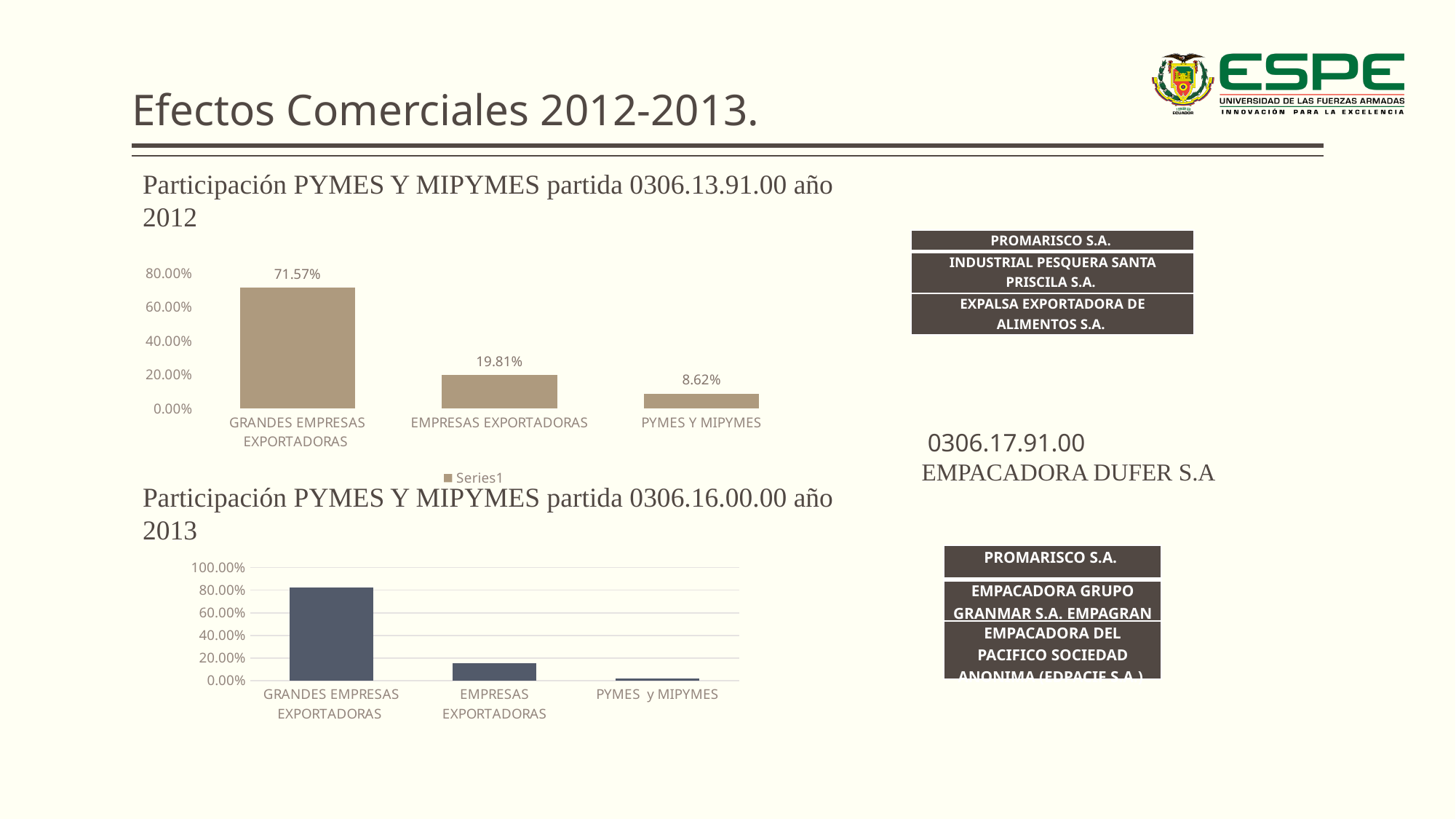
In the 2012 chart (partida 0306.13.91.00), what series name does the legend show? Series1 In the 2012 chart (partida 0306.13.91.00), which category has the lowest value? PYMES Y MIPYMES In the 2013 chart (partida 0306.16.00.00), is the value for GRANDES EMPRESAS EXPORTADORAS greater or less than 60.00%? greater In the 2012 chart (partida 0306.13.91.00), what is the value for PYMES Y MIPYMES? 8.62% In the 2013 chart (partida 0306.16.00.00), which category has the lowest value? PYMES y MIPYMES In the 2012 chart (partida 0306.13.91.00), what is the difference between GRANDES EMPRESAS EXPORTADORAS and EMPRESAS EXPORTADORAS? 51.76% In the 2012 chart (partida 0306.13.91.00), what is the value for EMPRESAS EXPORTADORAS? 19.81% In the 2012 chart (partida 0306.13.91.00), which category has the highest value? GRANDES EMPRESAS EXPORTADORAS In the 2013 chart (partida 0306.16.00.00), is the value for EMPRESAS EXPORTADORAS greater or less than 40.00%? less In the 2012 chart (partida 0306.13.91.00), how many categories are shown? 3 What type of chart is the 2013 chart (partida 0306.16.00.00)? Bar chart In the 2012 chart (partida 0306.13.91.00), what is the value for GRANDES EMPRESAS EXPORTADORAS? 71.57%